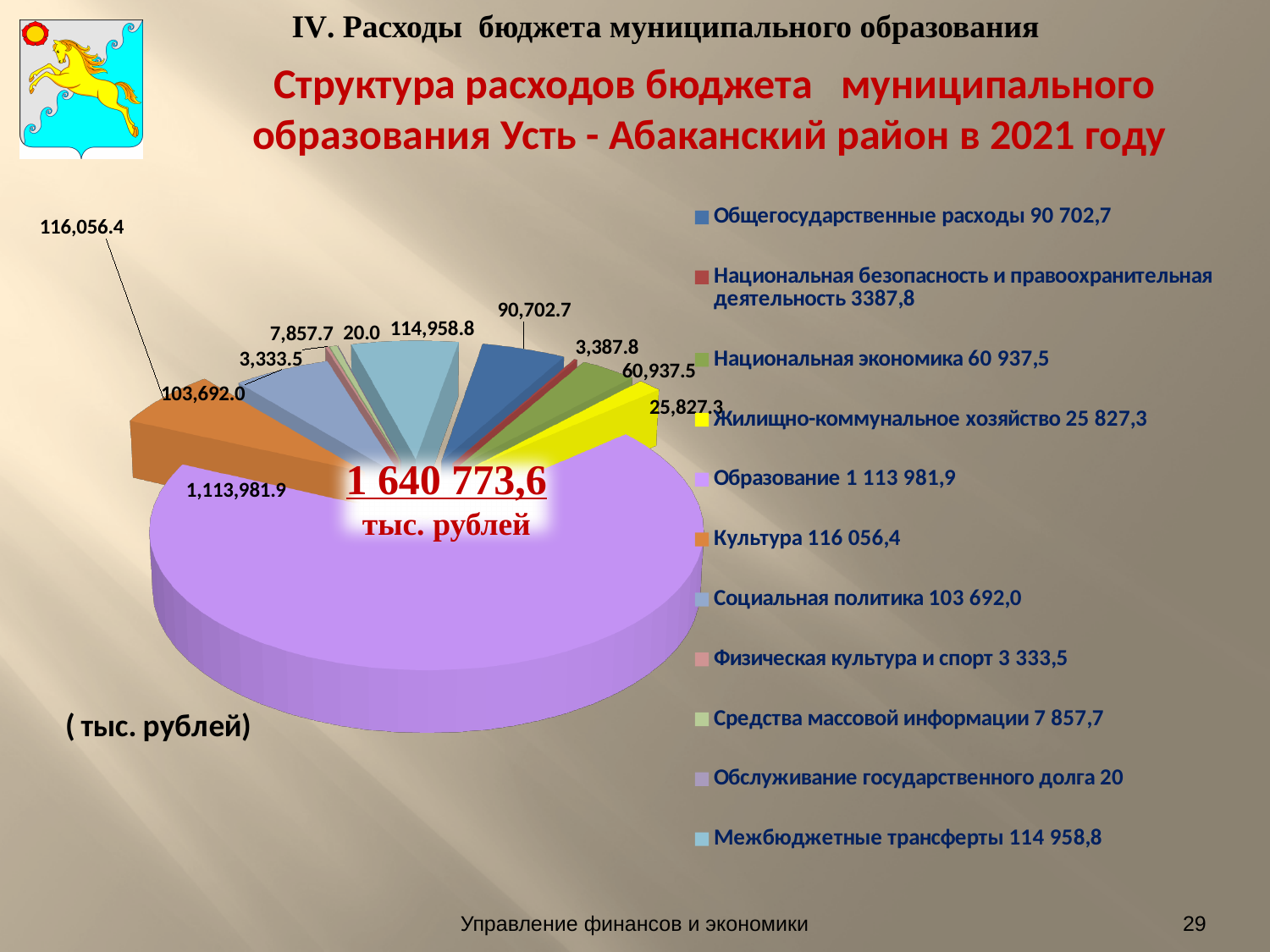
What is the value shown for Культура on the pie chart? 116,056.4 What is the value shown for Национальная экономика on the pie chart? 60,937.5 What is the value shown for Обслуживание государственного долга on the pie chart? 20.0 What is the difference between the values for Общегосударственные расходы and Национальная экономика? 29,765.2 Which category has the largest slice of the pie chart? Образование What is the value shown for Жилищно-коммунальное хозяйство on the pie chart? 25,827.3 What total amount is printed in the centre of the pie chart? 1 640 773,6 тыс. рублей What kind of chart is shown on the slide? pie chart What is the value shown for Образование on the pie chart? 1,113,981.9 Which is larger, the value for Культура or the value for Социальная политика? Культура How many categories does the legend of the pie chart list? 11 Which category has the smallest value in the pie chart? Обслуживание государственного долга